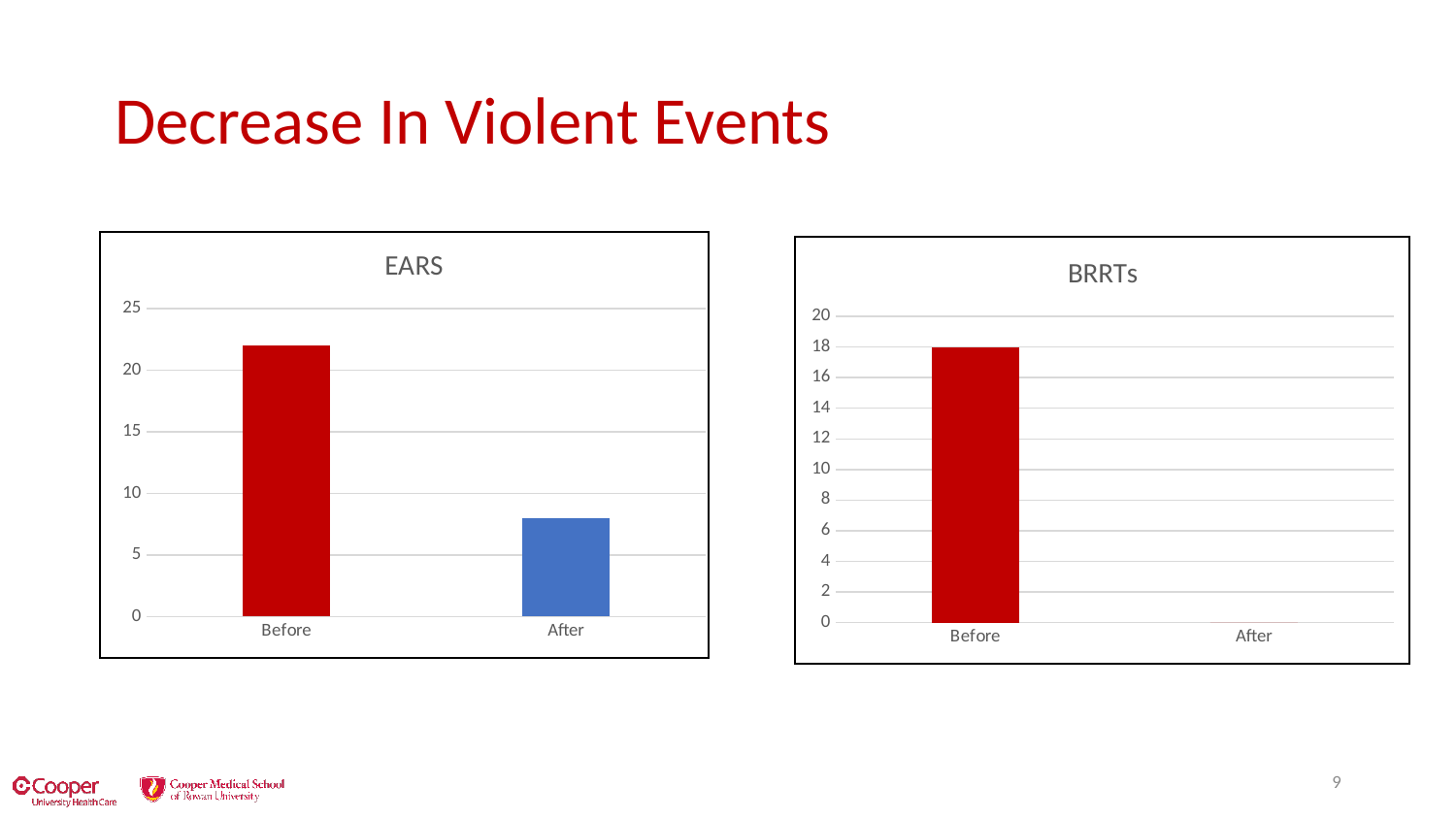
In the EARS chart, do the values rise or fall from Before to After? fall How many categories are shown on the x axis of the EARS chart? 2 In the BRRTs chart, what is the value for Before? 18 In the EARS chart, which category has the highest value? Before In the BRRTs chart, is the value for Before greater or less than 16? greater What is the title of the chart on the right side of the slide? BRRTs In the BRRTs chart, which category has the highest value? Before What kind of chart is the EARS chart? bar chart In the EARS chart, is the value for After greater or less than 10? less In the BRRTs chart, what is the value for After? 0 In the EARS chart, is the value for Before greater or less than 20? greater In the EARS chart, which category has the lowest value? After